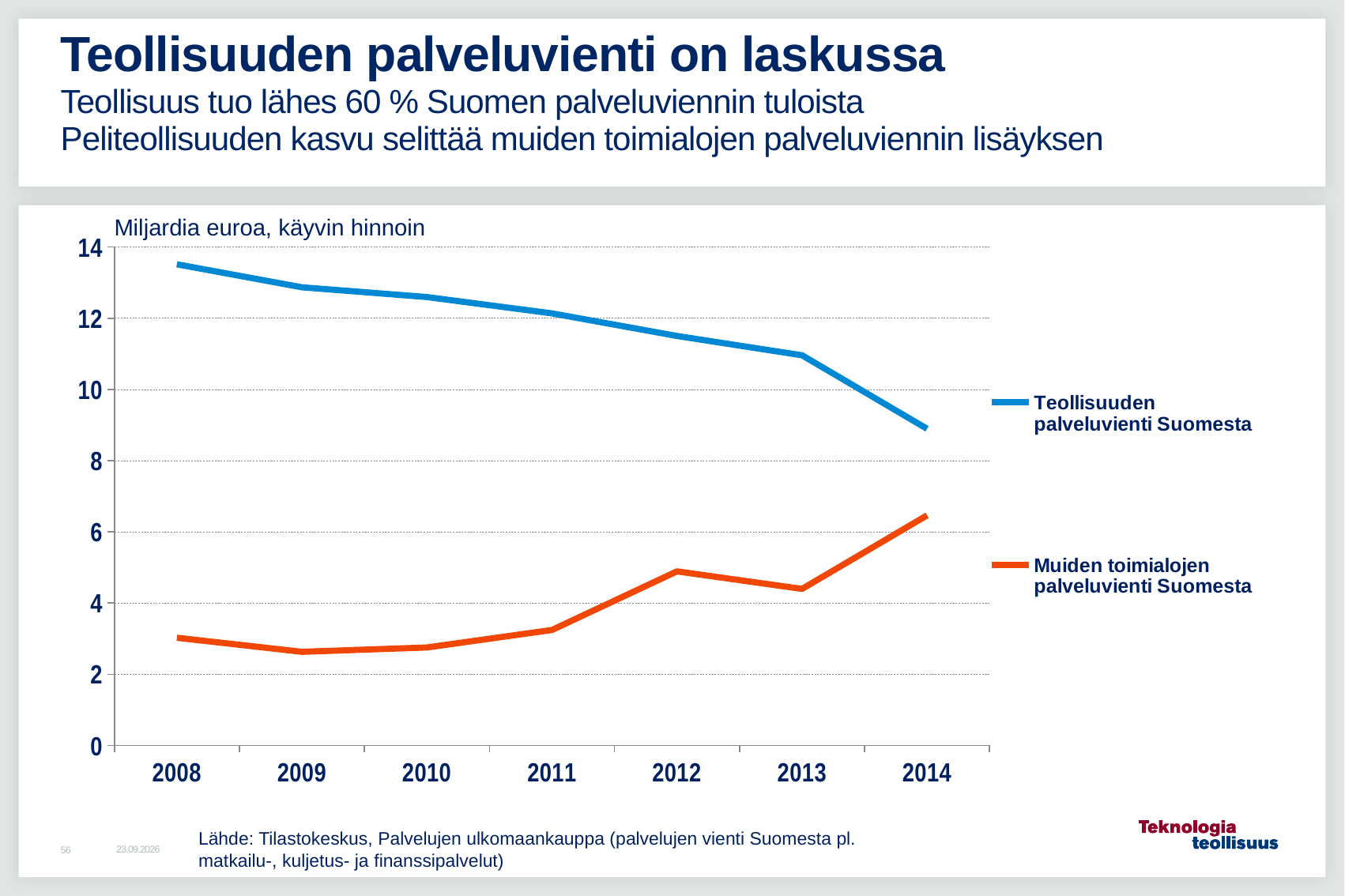
What unit is stated above the y axis of the chart? Miljardia euroa, käyvin hinnoin Does the line for Teollisuuden palveluvienti Suomesta rise or fall from 2008 to 2014? fall Is the value for Muiden toimialojen palveluvienti Suomesta in 2014 greater or less than 6? greater In which year is Muiden toimialojen palveluvienti Suomesta highest? 2014 In which year is Teollisuuden palveluvienti Suomesta highest? 2008 What kind of chart is shown on the slide? line chart In which year is Teollisuuden palveluvienti Suomesta lowest? 2014 In 2014, which series has the larger value: Teollisuuden palveluvienti Suomesta or Muiden toimialojen palveluvienti Suomesta? Teollisuuden palveluvienti Suomesta How many series does the legend list? 2 Is the value for Teollisuuden palveluvienti Suomesta in 2014 greater or less than 10? less How many years are shown on the x axis? 7 Does the line for Muiden toimialojen palveluvienti Suomesta rise or fall overall from 2008 to 2014? rise